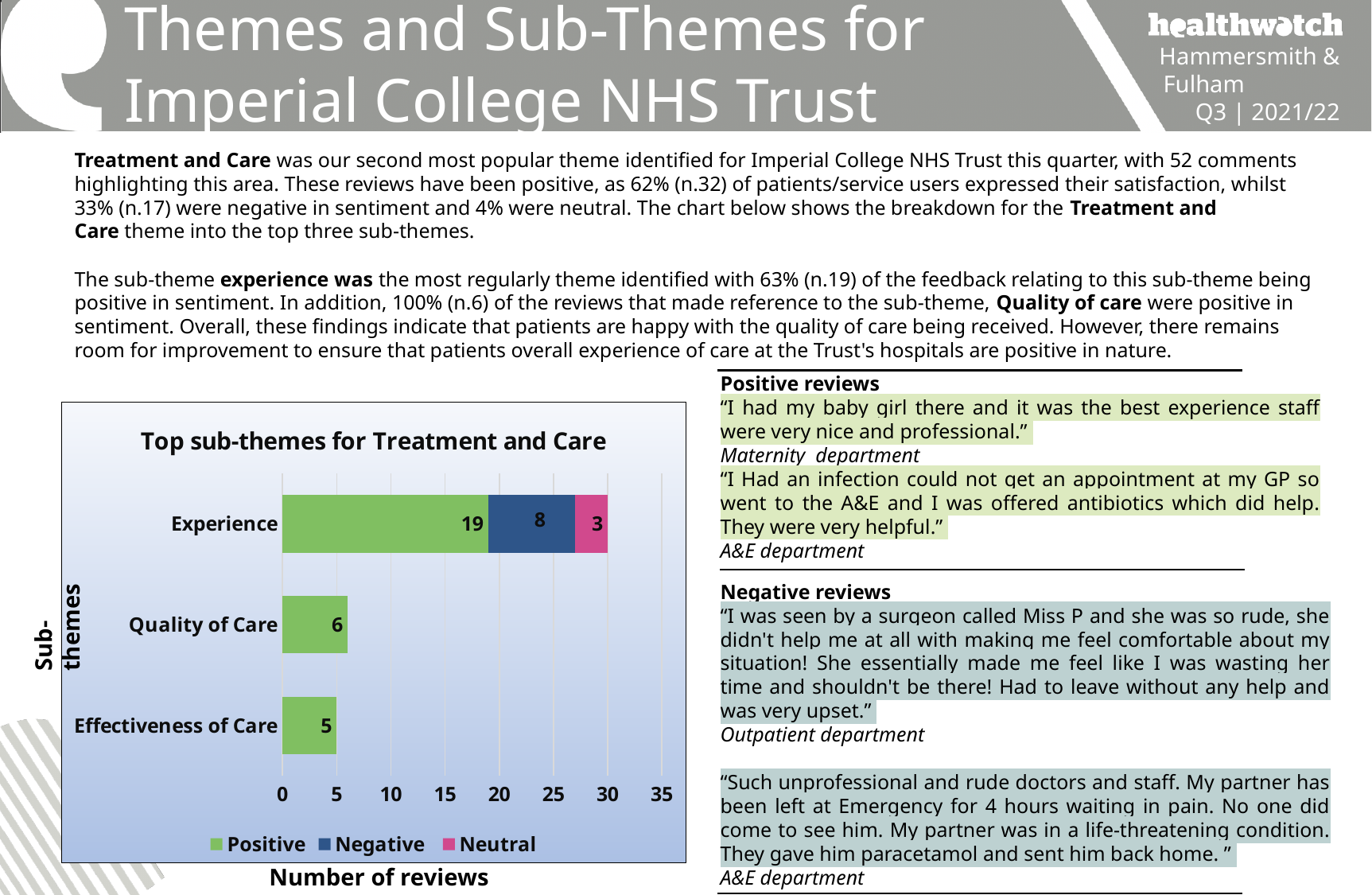
Which has more positive reviews, Experience or Quality of Care? Experience What is the title of the chart? Top sub-themes for Treatment and Care Which sub-theme has the highest total number of reviews? Experience How many neutral reviews are shown for Experience? 3 What kind of chart is shown on the slide? Stacked bar chart How many sub-themes are plotted on the chart? 3 What is the difference between the positive reviews for Quality of Care and Effectiveness of Care? 1 How many positive reviews are shown for Experience? 19 How many positive reviews are shown for Quality of Care? 6 What is the total number of reviews for Experience? 30 How many negative reviews are shown for Experience? 8 How many series does the chart legend list? 3